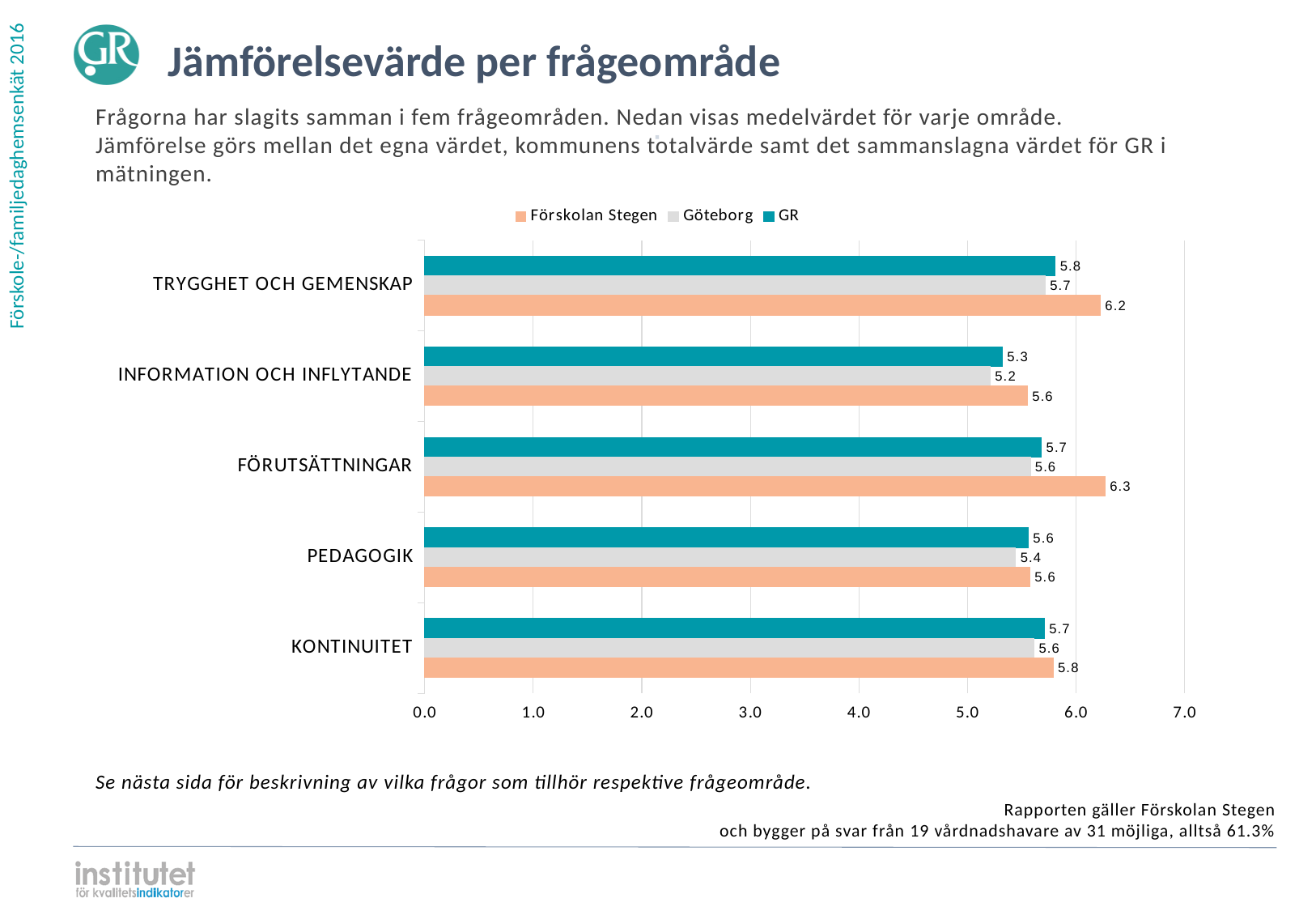
What kind of chart is shown on the slide? Bar chart Which series is shown in orange in the legend? Förskolan Stegen Which category has the lowest Göteborg value? Information och inflytande What is the value for Förskolan Stegen in the Förutsättningar category? 6.3 What is the difference between the Förskolan Stegen and Göteborg values for Trygghet och gemenskap? 0.5 For Pedagogik, which is larger: the GR value or the Göteborg value? GR How many series does the legend list? 3 Is the Förskolan Stegen value for Kontinuitet greater or less than 5.0? greater How many categories (frågeområden) are shown on the chart? 5 Which category has the highest Förskolan Stegen value? Förutsättningar What is the GR value for Trygghet och gemenskap? 5.8 What is the Göteborg value for Information och inflytande? 5.2